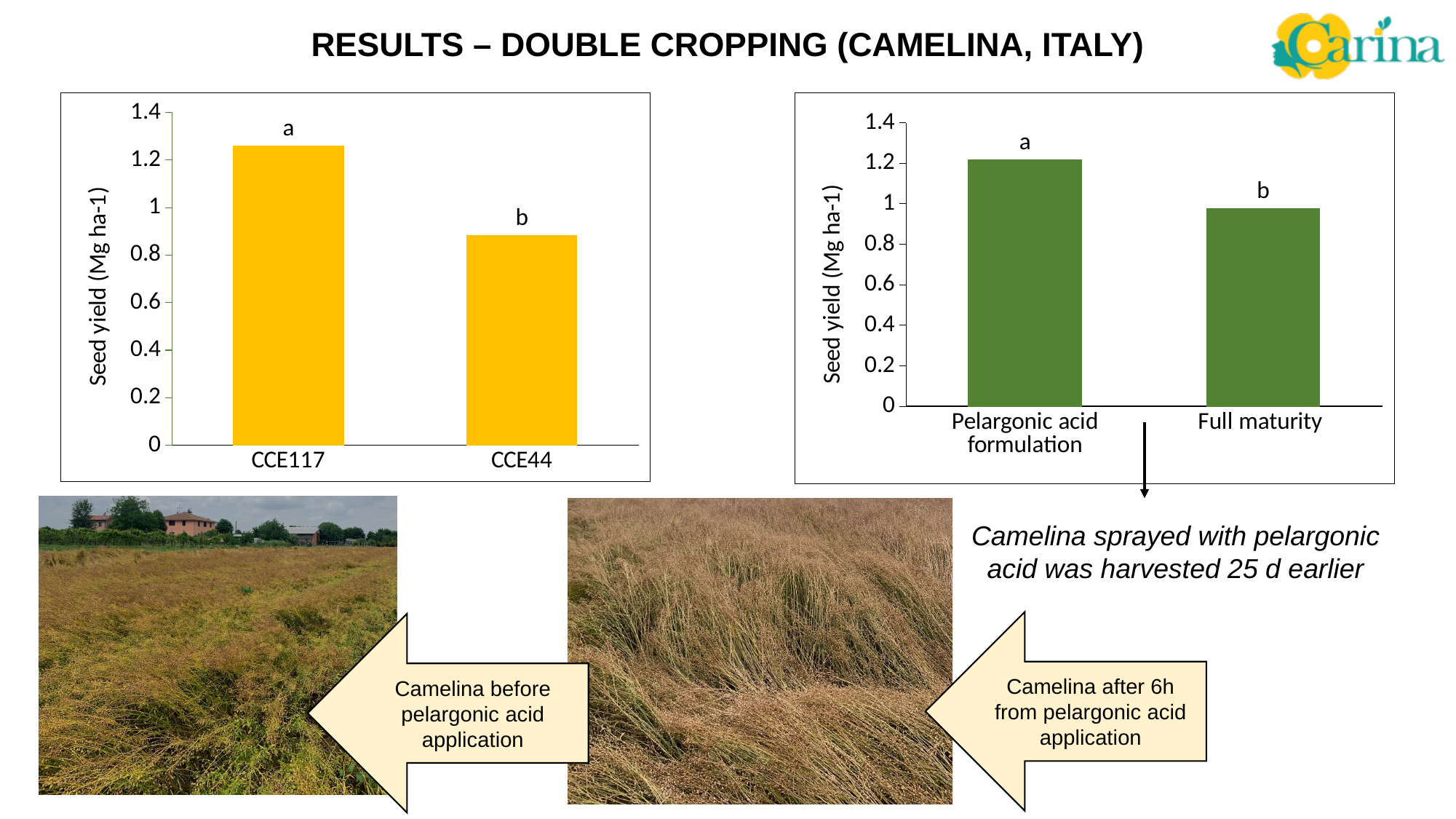
In the left chart, is the seed yield for CCE44 greater or less than 1? less In the left chart, is the seed yield for CCE44 greater or less than 0.8? greater In the right chart, is the seed yield for Pelargonic acid formulation greater or less than 1? greater How many categories are shown in the left chart? 2 In the left chart, which category has the higher seed yield? CCE117 What kind of chart is the right chart? bar chart In the right chart, which category has the higher seed yield? Pelargonic acid formulation In the right chart, which category has the lower seed yield? Full maturity In the left chart, which category has the lower seed yield? CCE44 What is the y-axis label of the left chart? Seed yield (Mg ha-1)